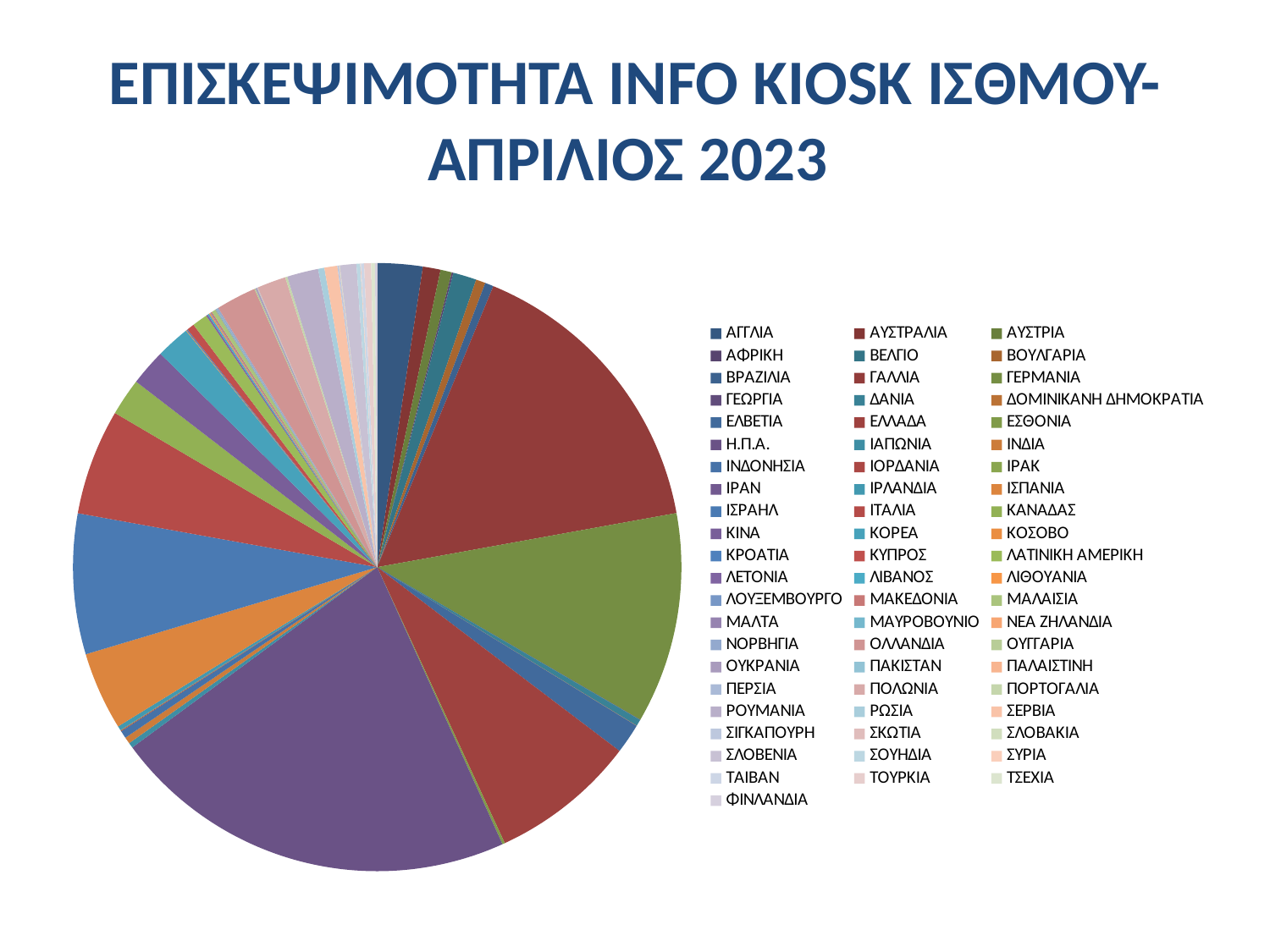
How many categories (countries/regions) does the legend of the pie chart list? 64 Which slice is larger, ΓΕΡΜΑΝΙΑ or ΑΥΣΤΡΑΛΙΑ? ΓΕΡΜΑΝΙΑ How many data series does the pie chart plot? 1 What kind of chart is shown on the slide? pie chart What is the title of the chart on the slide? ΕΠΙΣΚΕΨΙΜΟΤΗΤΑ INFO KIOSK ΙΣΘΜΟΥ-ΑΠΡΙΛΙΟΣ 2023 Which slice is larger, Η.Π.Α. or ΓΑΛΛΙΑ? Η.Π.Α. Which slice is larger, ΓΑΛΛΙΑ or ΓΕΡΜΑΝΙΑ? ΓΑΛΛΙΑ Which is the first category listed in the legend of the pie chart? ΑΓΓΛΙΑ Does the pie chart show data labels with values on its slices? No Which category has the largest slice of the pie chart? Η.Π.Α.